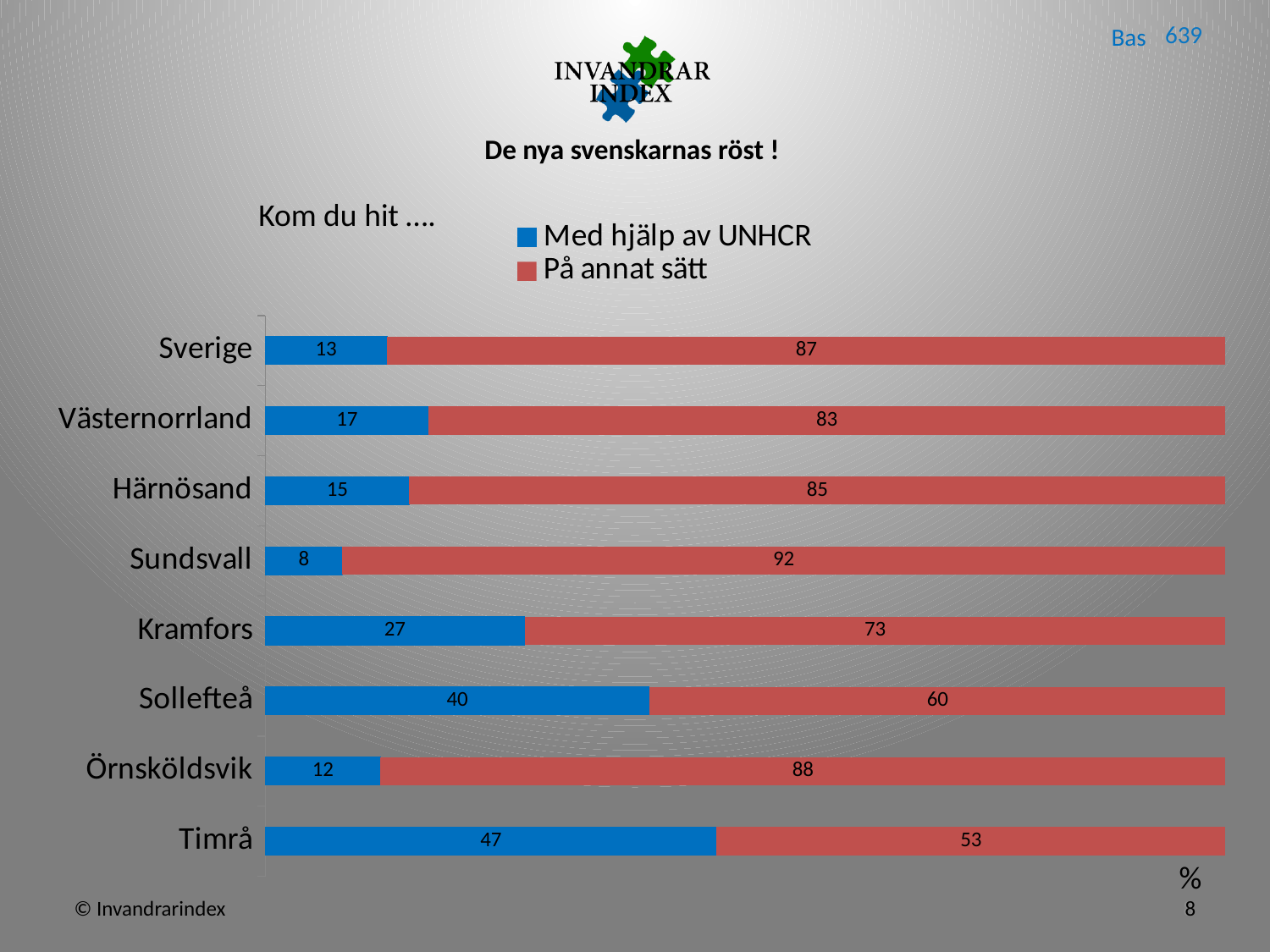
Which category has the lowest value for "Med hjälp av UNHCR"? Sundsvall What is the total of the stacked bar for Timrå? 100 How many series does the legend list? 2 Which series is shown in blue? Med hjälp av UNHCR Which category has the highest value for "Med hjälp av UNHCR"? Timrå What kind of chart is shown on the slide? Stacked bar chart What is the value for "På annat sätt" for Sundsvall? 92 What is the value for "Med hjälp av UNHCR" for Sverige? 13 What is the difference between the "På annat sätt" values for Örnsköldsvik and Kramfors? 15 What is the value for "Med hjälp av UNHCR" for Sollefteå? 40 How many categories are shown on the chart? 8 Which has a larger "Med hjälp av UNHCR" value, Härnösand or Västernorrland? Västernorrland